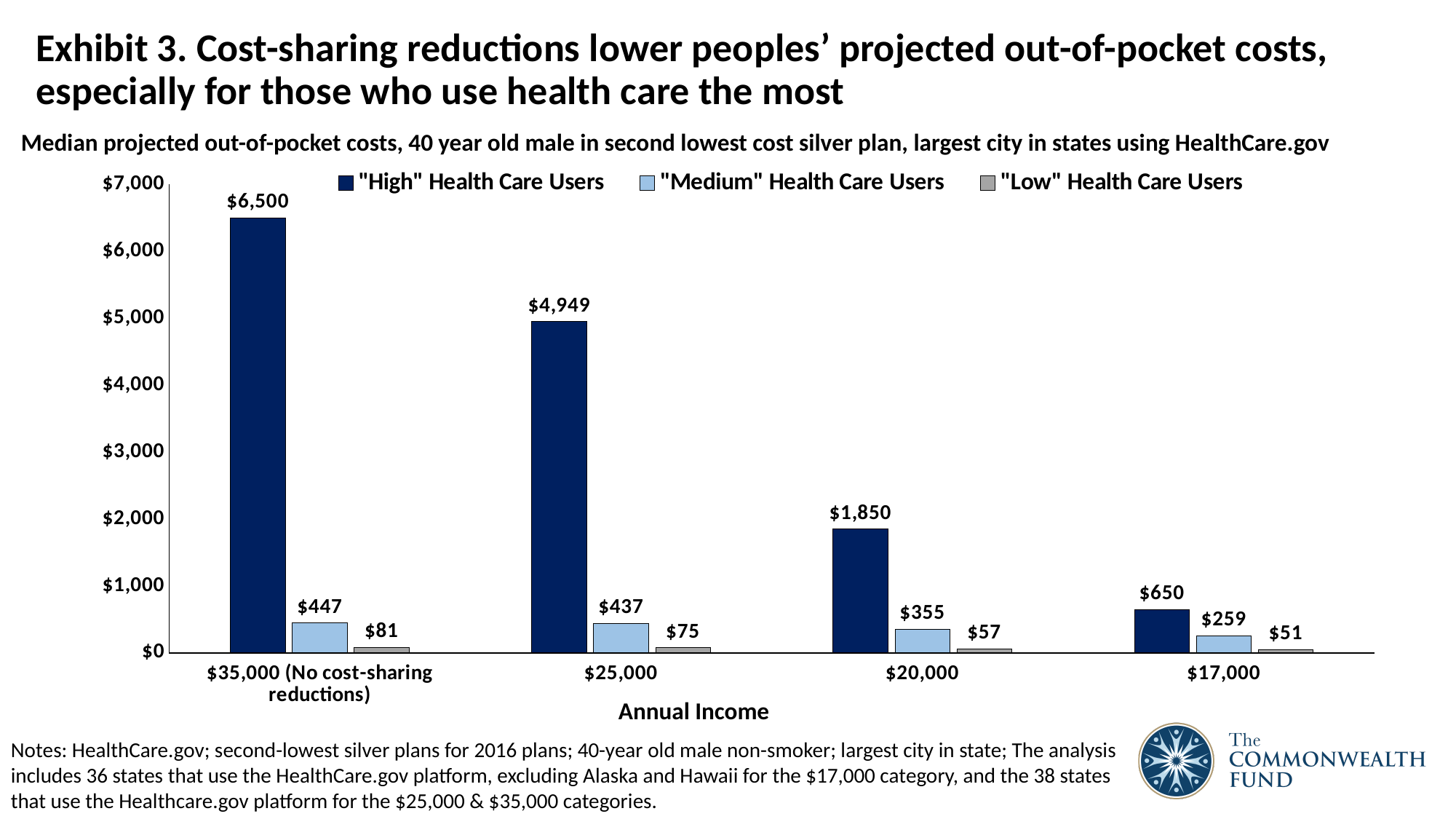
What is the median projected out-of-pocket cost for "High" Health Care Users at the $25,000 annual income level? $4,949 At which annual income level is the value for "Medium" Health Care Users the lowest? $17,000 Which is larger: the "Medium" Health Care Users value at $35,000 or the "High" Health Care Users value at $17,000? "High" Health Care Users value at $17,000 At which annual income level is the value for "High" Health Care Users the highest? $35,000 (No cost-sharing reductions) How many annual income categories are shown on the x axis? 4 What is the difference between the "Medium" and "Low" Health Care Users values at the $25,000 income level? $362 How many series does the legend list? 3 What is the value for "Medium" Health Care Users at the $20,000 annual income level? $355 Do the values for "High" Health Care Users rise or fall moving from $35,000 to $17,000 along the x axis? Fall What is the difference between the "High" Health Care Users values at $35,000 and $17,000? $5,850 What kind of chart is shown on the slide? Bar chart What is the value for "Low" Health Care Users at the $17,000 annual income level? $51